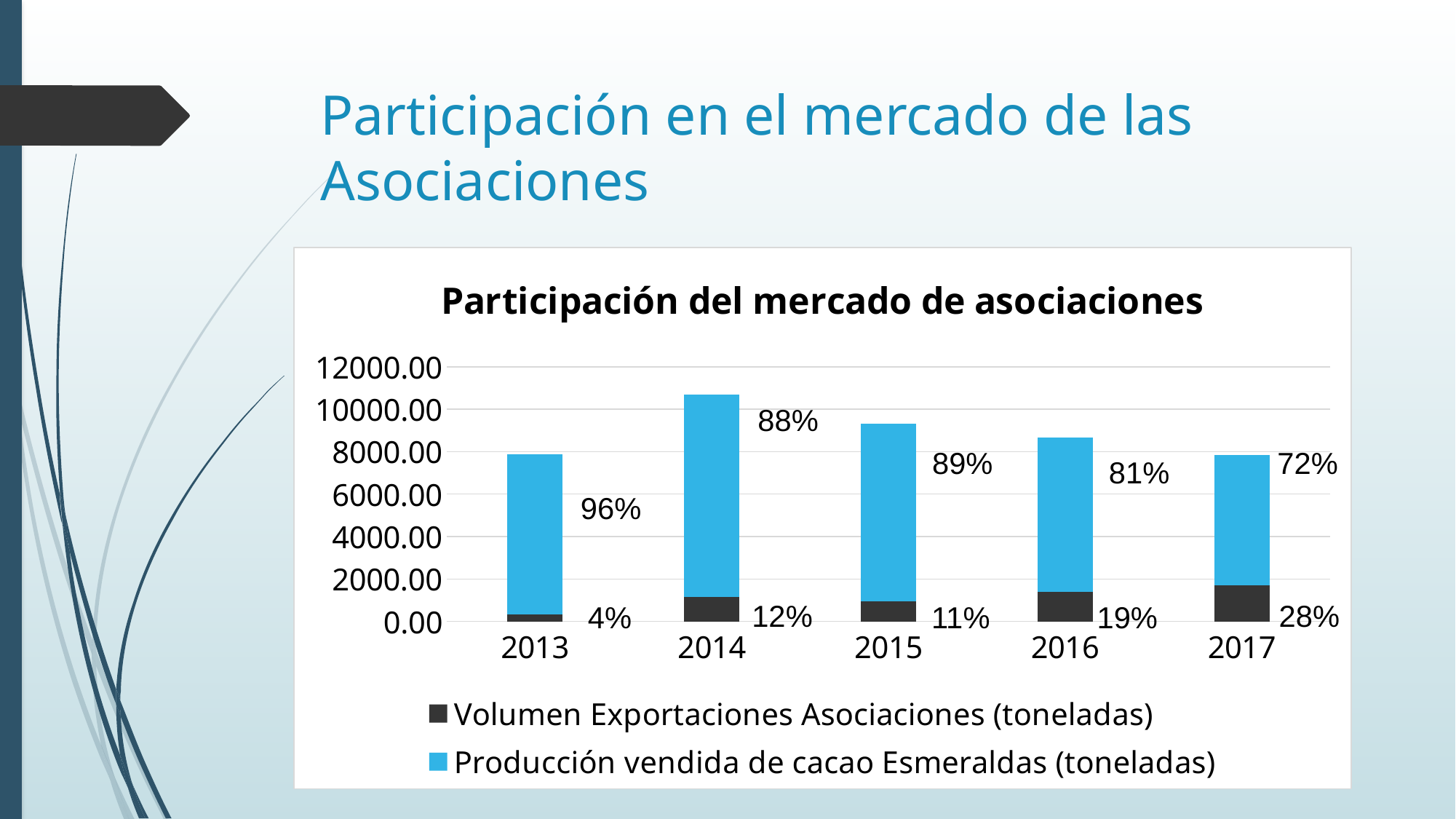
Is the total height of the stacked bar for 2015 greater or less than 8000.00? greater What is the title of the chart? Participación del mercado de asociaciones Is the total height of the stacked bar for 2014 greater or less than 10000.00? greater Which year has the tallest stacked bar? 2014 Which is larger, the percentage label for Producción vendida de cacao Esmeraldas in 2016 or in 2017? 2016 How many years are shown on the x axis? 5 Which year has the lowest percentage label for Volumen Exportaciones Asociaciones (toneladas)? 2013 What percentage label is shown for Volumen Exportaciones Asociaciones (toneladas) in 2015? 11% How many series does the legend list? 2 What percentage label is shown for Volumen Exportaciones Asociaciones (toneladas) in 2017? 28% What kind of chart is shown on the slide? Stacked bar chart What percentage label is shown for Producción vendida de cacao Esmeraldas (toneladas) in 2013? 96%